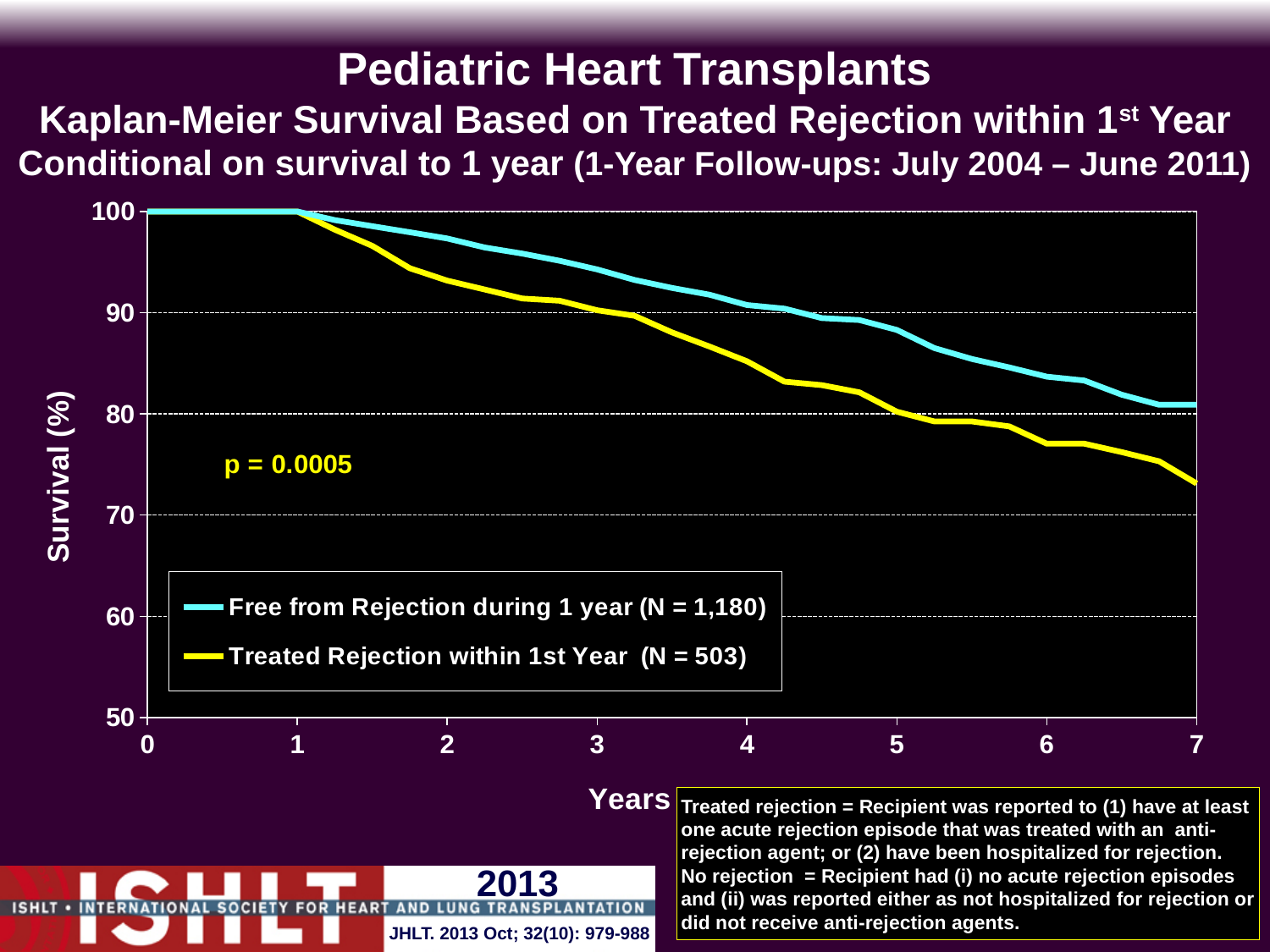
Is the survival value for Treated Rejection within 1st Year at year 7 greater or less than 70? greater What is the survival (%) for both curves at year 0? 100 At year 5, which group has the higher survival: Free from Rejection during 1 year or Treated Rejection within 1st Year? Free from Rejection during 1 year What kind of chart is shown on the slide? line chart Is the survival value for Free from Rejection during 1 year at year 3 greater or less than 90? greater What is the N for the Treated Rejection within 1st Year group in the legend? 503 Is the survival value for Free from Rejection during 1 year at year 7 greater or less than 80? greater What is the p-value shown on the chart? p = 0.0005 How many series does the legend list? 2 Do the survival curves rise or fall as years increase? fall